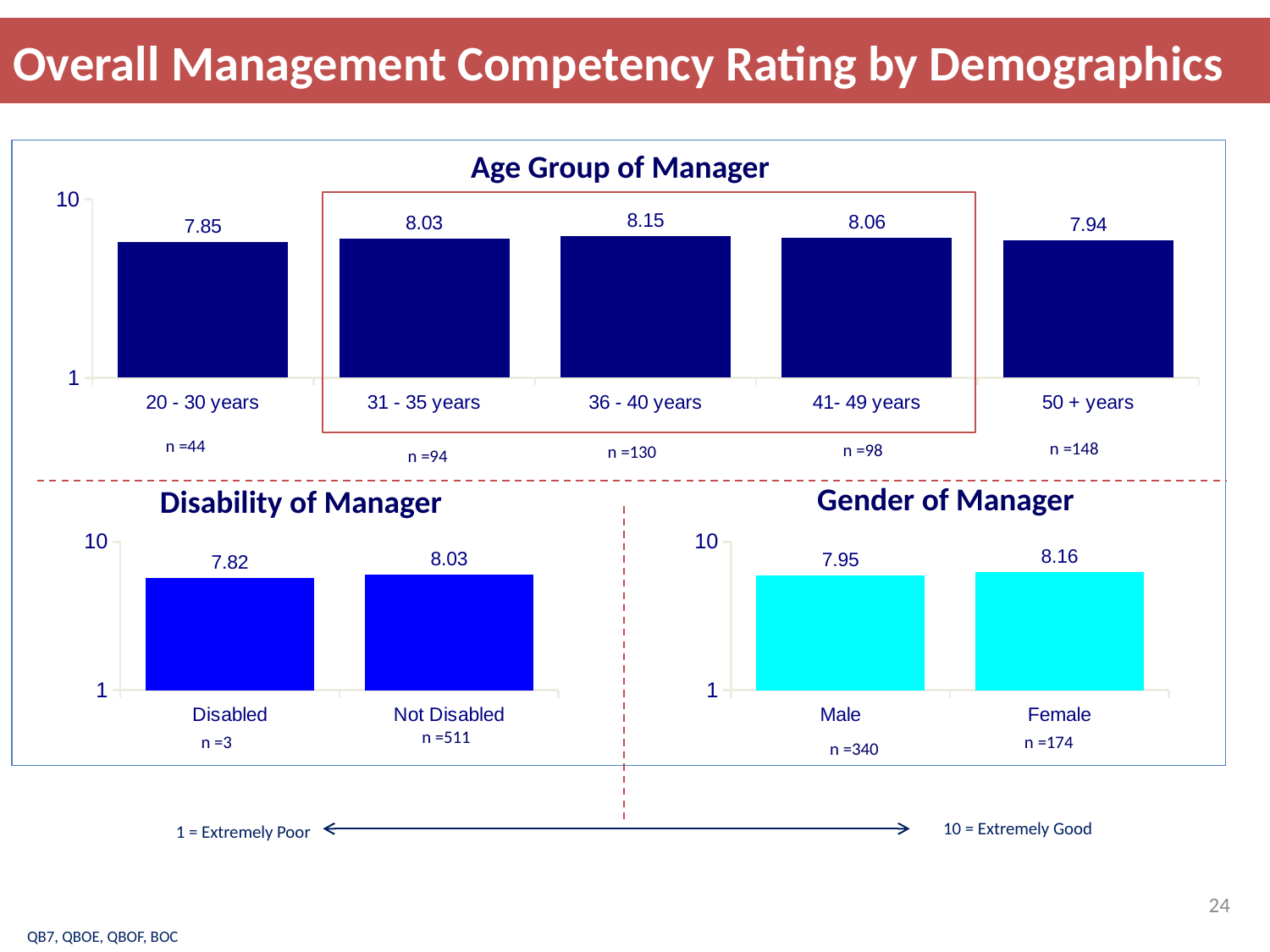
In the Gender of Manager chart, what is the rating for Female? 8.16 In the Age Group of Manager chart, what is the rating for 50 + years? 7.94 What kind of chart is the Gender of Manager chart? Bar chart In the Age Group of Manager chart, what is the rating for 36 - 40 years? 8.15 In the Disability of Manager chart, what is the rating for Disabled? 7.82 In the Gender of Manager chart, what is the difference between the Female and Male ratings? 0.21 In the Age Group of Manager chart, how many age groups are shown? 5 In the Disability of Manager chart, which category has the higher rating, Disabled or Not Disabled? Not Disabled In the Age Group of Manager chart, which age group has the lowest rating? 20 - 30 years In the Age Group of Manager chart, which age group has the highest rating? 36 - 40 years In the Age Group of Manager chart, what is the difference between the ratings for 36 - 40 years and 20 - 30 years? 0.30 In the Age Group of Manager chart, which age groups are enclosed by the red outline box? 31 - 35 years, 36 - 40 years, 41- 49 years